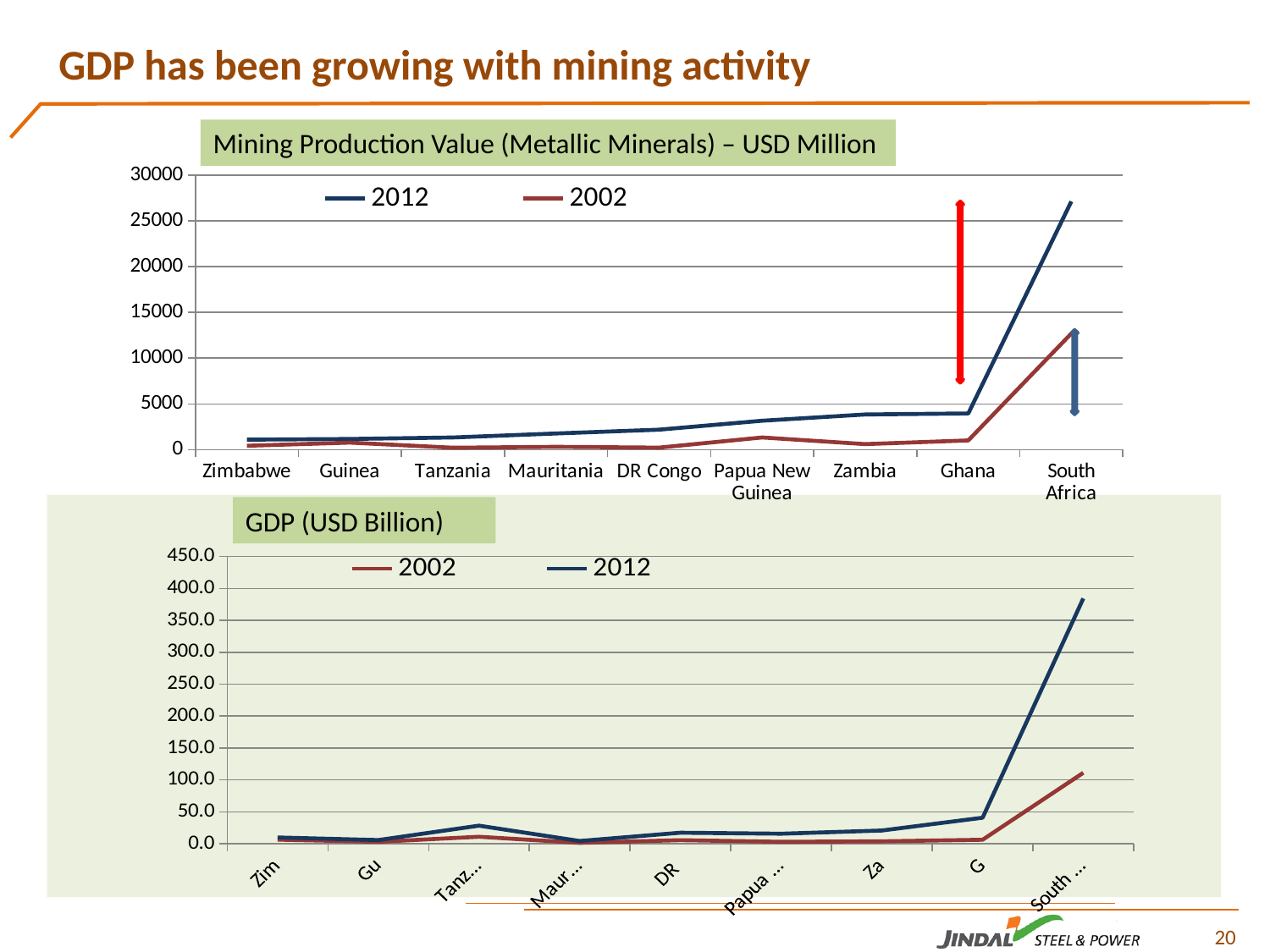
In the 'Mining Production Value (Metallic Minerals) – USD Million' chart, is the 2002 value for South Africa greater or less than 15000? less In the 'Mining Production Value (Metallic Minerals) – USD Million' chart, how many countries are shown on the x axis? 9 In the 'GDP (USD Billion)' chart, is the 2012 value for the rightmost category (South ...) greater or less than 350.0? greater What kind of chart is the 'GDP (USD Billion)' chart? line chart What are the two legend entries in the 'Mining Production Value (Metallic Minerals) – USD Million' chart? 2012 and 2002 In the 'GDP (USD Billion)' chart, how many series does the legend list? 2 What kind of chart is the 'Mining Production Value (Metallic Minerals) – USD Million' chart? line chart In the 'Mining Production Value (Metallic Minerals) – USD Million' chart, how many series does the legend list? 2 In the 'Mining Production Value (Metallic Minerals) – USD Million' chart, which country has the highest 2012 value? South Africa In the 'Mining Production Value (Metallic Minerals) – USD Million' chart, is the 2012 value for Ghana greater or less than 5000? less In the 'Mining Production Value (Metallic Minerals) – USD Million' chart, which series has the larger value for South Africa, 2012 or 2002? 2012